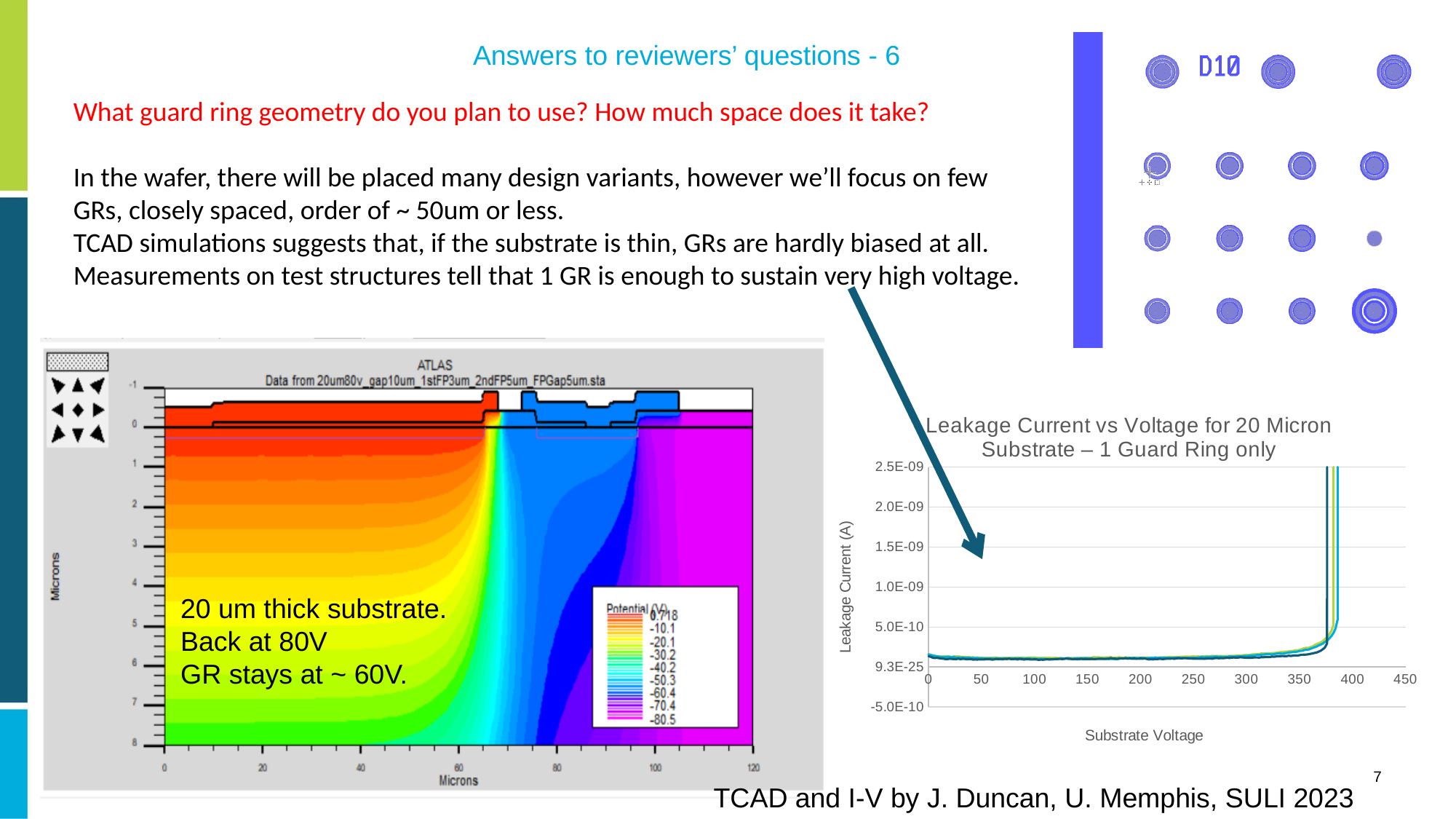
In the leakage current chart, what is the label of the x axis? Substrate Voltage In the leakage current chart, is the leakage current at a substrate voltage of 200 greater or less than 5.0E-10? less In the leakage current chart, is the leakage current at a substrate voltage of 100 greater or less than 1.0E-09? less In the leakage current chart, what is the label of the y axis? Leakage Current (A) In the leakage current chart, what is the highest leakage current tick shown on the y axis? 2.5E-09 In the leakage current chart, does the leakage current stay roughly flat or rise sharply as the substrate voltage approaches 400? rises sharply What kind of chart is the 'Leakage Current vs Voltage for 20 Micron Substrate – 1 Guard Ring only' chart? line chart In the leakage current chart, is the leakage current at a substrate voltage of 300 greater or less than 5.0E-10? less